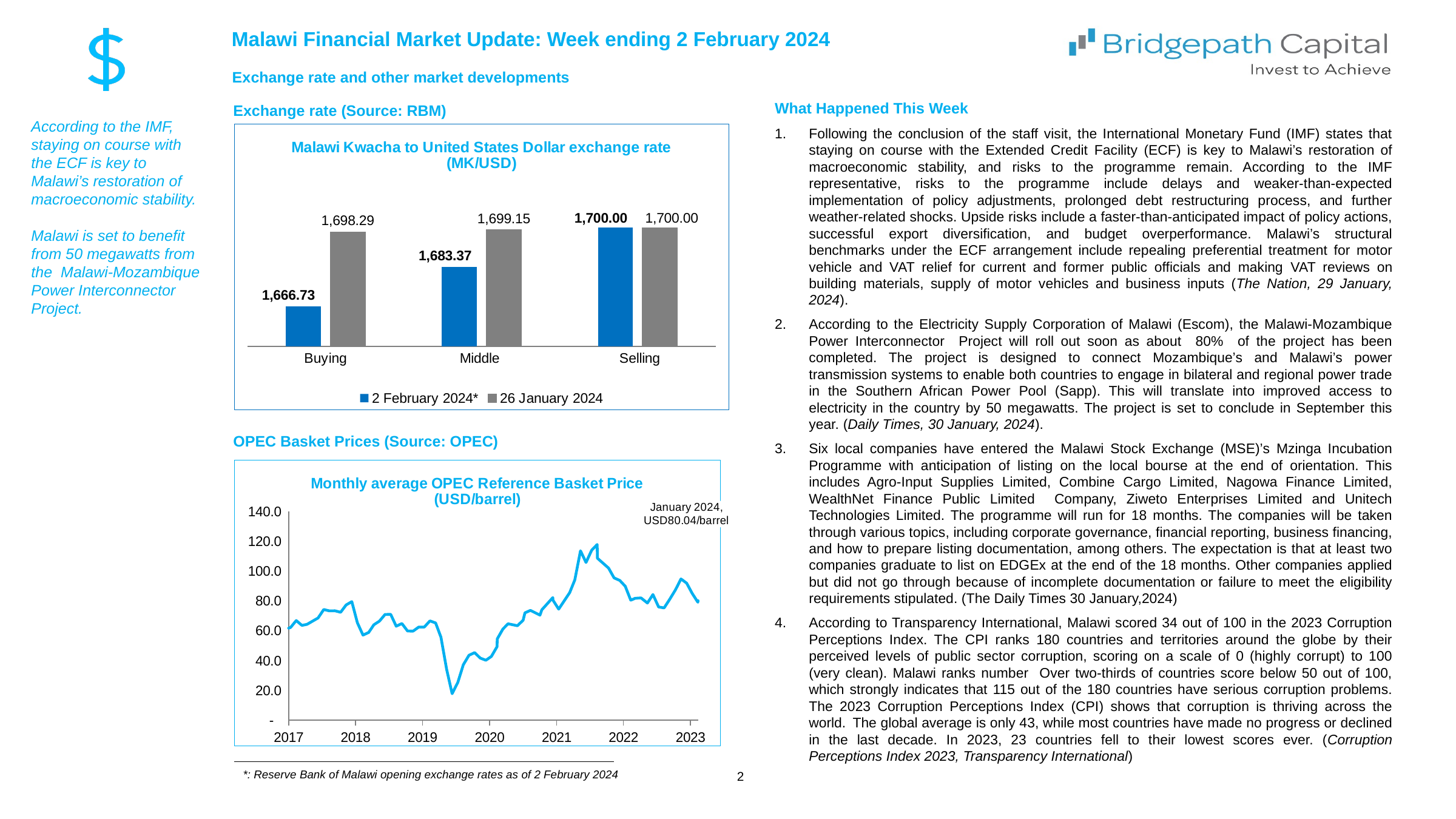
In the Malawi Kwacha to United States Dollar exchange rate chart, what is the difference between the Middle rate on 26 January 2024 and on 2 February 2024*? 15.78 In the Malawi Kwacha to United States Dollar exchange rate chart, what is the difference between the Buying rate on 26 January 2024 and on 2 February 2024*? 31.56 In the Monthly average OPEC Reference Basket Price chart, what value is labelled for January 2024? USD80.04/barrel In the Malawi Kwacha to United States Dollar exchange rate chart, what is the Middle rate for 26 January 2024? 1,699.15 In the Monthly average OPEC Reference Basket Price chart, is the lowest point of the line (around 2020) greater or less than 40.0? less How many categories are shown on the x axis of the Malawi Kwacha to United States Dollar exchange rate chart? 3 In the Malawi Kwacha to United States Dollar exchange rate chart, what is the Buying rate for 2 February 2024*? 1,666.73 What kind of chart is the Monthly average OPEC Reference Basket Price chart? Line chart In the Malawi Kwacha to United States Dollar exchange rate chart, which is larger for the Middle rate: 2 February 2024* or 26 January 2024? 26 January 2024 What kind of chart is the Malawi Kwacha to United States Dollar exchange rate chart? Bar chart In the Malawi Kwacha to United States Dollar exchange rate chart, which category has the lowest value for 2 February 2024*? Buying How many series does the legend of the Malawi Kwacha to United States Dollar exchange rate chart list? 2